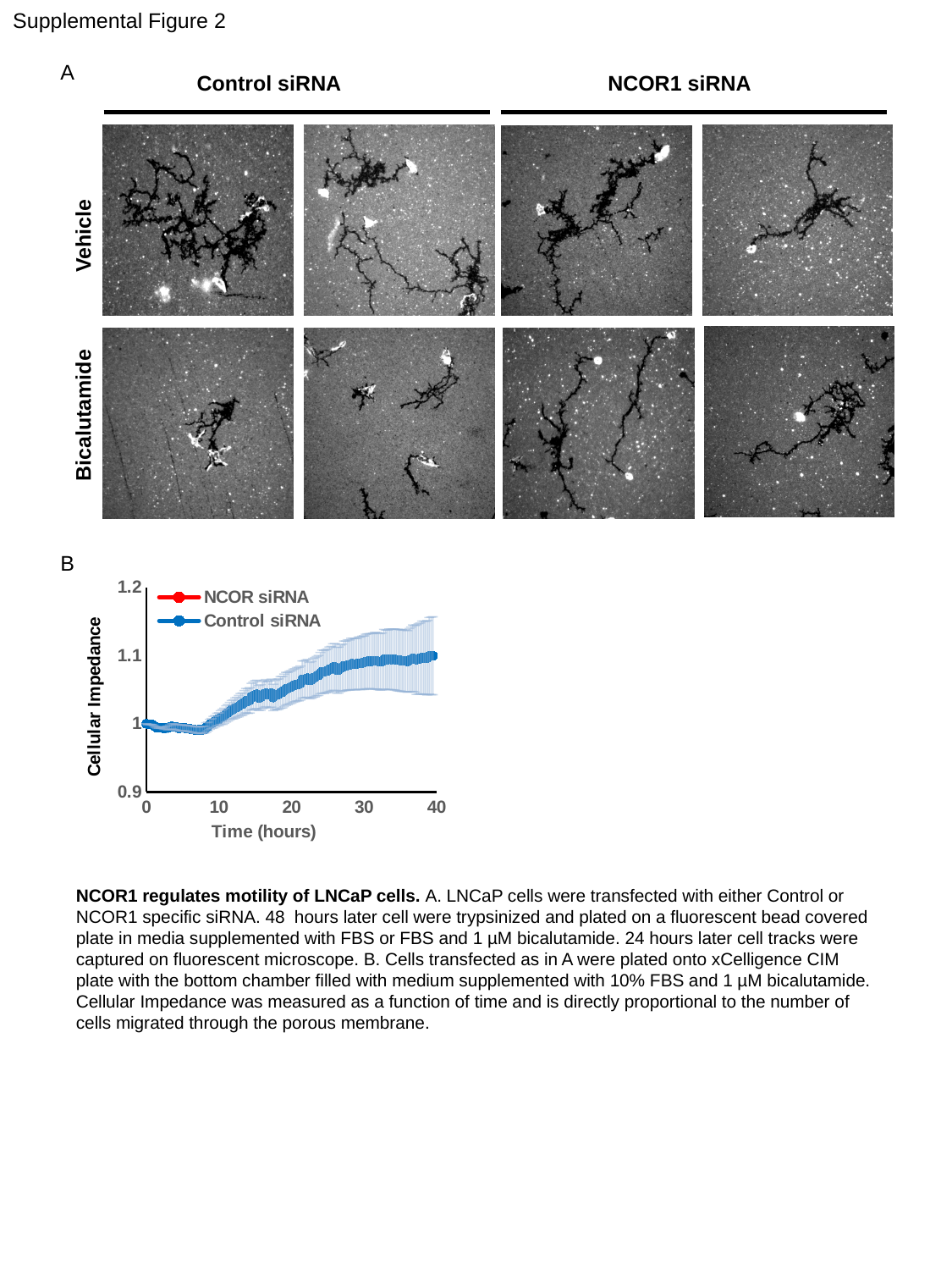
In the chart in panel B, is the Control siRNA value at 40 hours larger or smaller than its value at 0 hours? larger In the chart in panel B, is the Control siRNA value at 5 hours greater or less than 1.1? less In the chart in panel B, is the Control siRNA value at 40 hours greater or less than 1.2? less In the chart in panel B, is the Control siRNA value at 30 hours greater or less than 1? greater In the chart in panel B, what is the label of the x axis? Time (hours) In the chart in panel B, how many series does the legend list? 2 In the chart in panel B, what is the label of the y axis? Cellular Impedance In the chart in panel B, what kind of chart is shown? line chart In the chart in panel B, does the Control siRNA cellular impedance rise or fall between 10 and 40 hours? rise